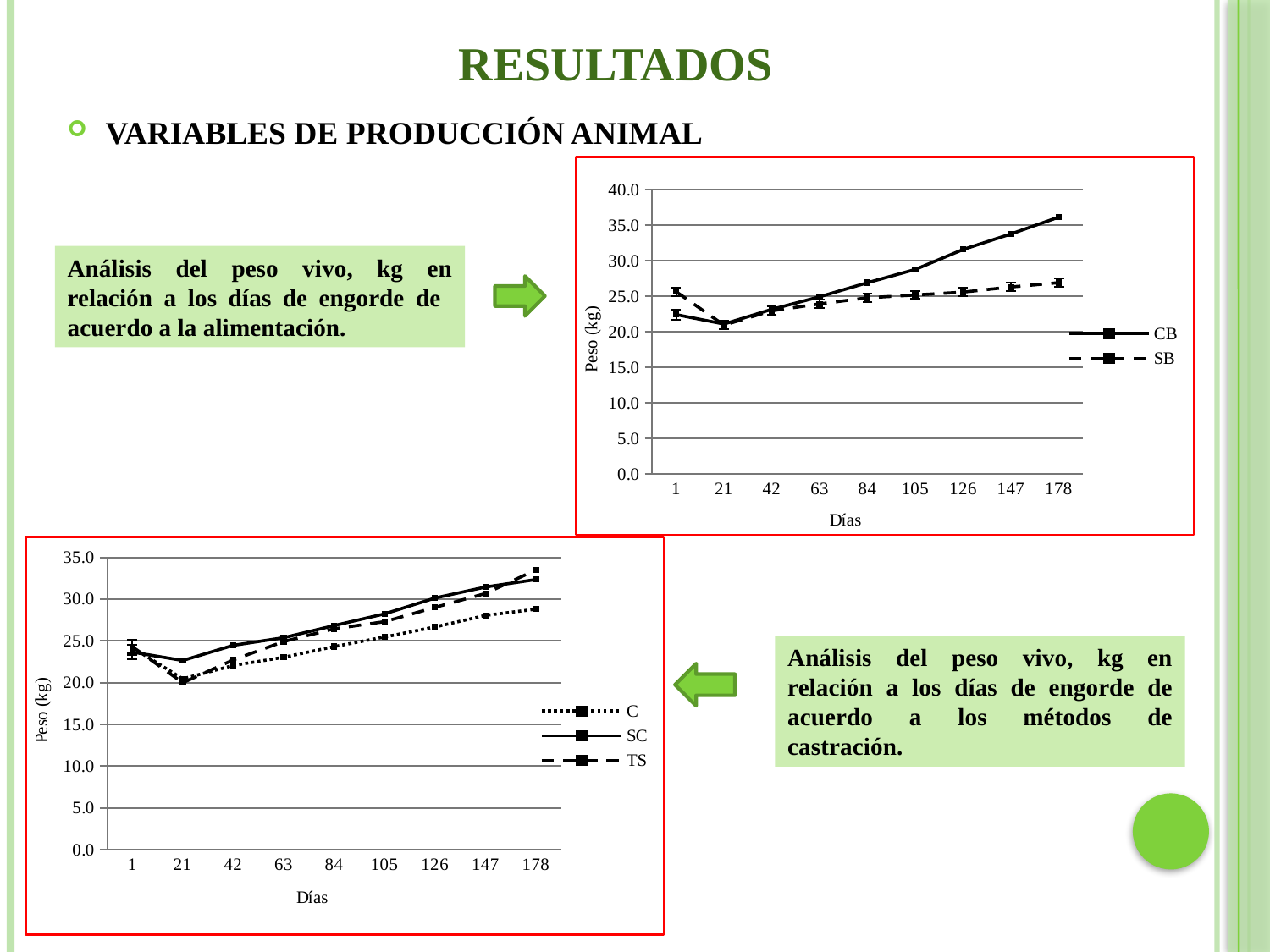
How many series does the legend of the bottom-left chart list? 3 In the top-right chart, which series has the larger value at day 178, CB or SB? CB What is the y-axis title of the bottom-left chart? Peso (kg) In the top-right chart, is the value for SB at day 178 greater or less than 30.0? less How many day values are shown on the x axis of the bottom-left chart? 9 What kind of chart is the top-right chart (CB and SB)? line chart In the top-right chart, which series has the larger value at day 1, CB or SB? SB In the bottom-left chart, do the values for SC generally rise or fall from day 21 to day 178? rise In the bottom-left chart, which series has the lowest value at day 178? C In the top-right chart, is the value for CB at day 178 greater or less than 30.0? greater In the bottom-left chart, is the value for C at day 178 greater or less than 30.0? less How many series does the legend of the top-right chart list? 2